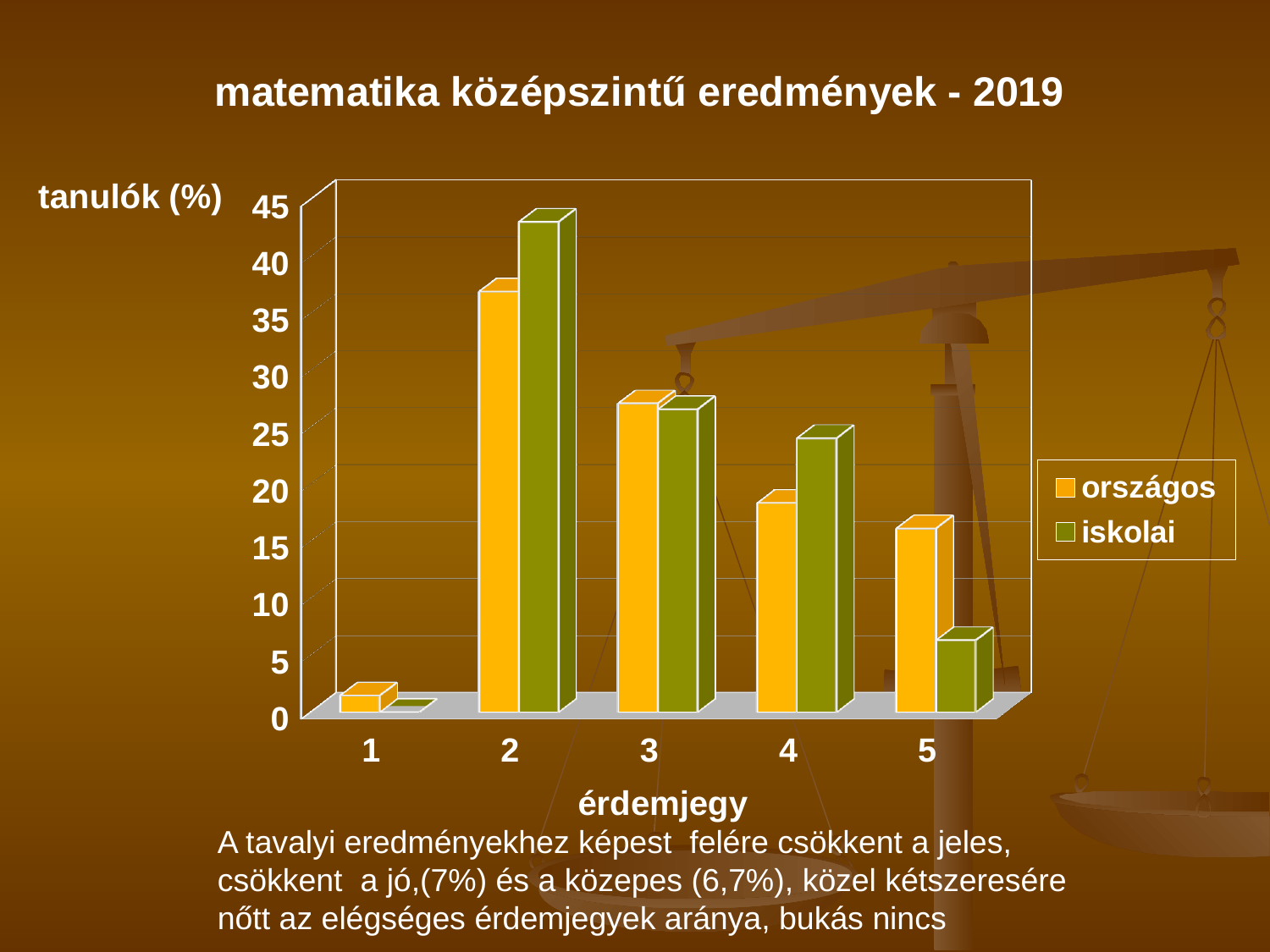
For grade 2, which is larger: országos or iskolai? iskolai What is the title of the chart? matematika középszintű eredmények - 2019 For which grade is the iskolai value highest? 2 What kind of chart is shown on the slide? bar chart For which grade is the iskolai value lowest? 1 For which grade is the országos value highest? 2 For grade 5, which is larger: országos or iskolai? országos How many series does the legend list? 2 Is the iskolai value for grade 5 greater or less than 10? less How many grade categories (érdemjegy) are shown on the x axis? 5 Is the iskolai value for grade 2 greater or less than 40? greater What are the two series named in the legend? országos, iskolai